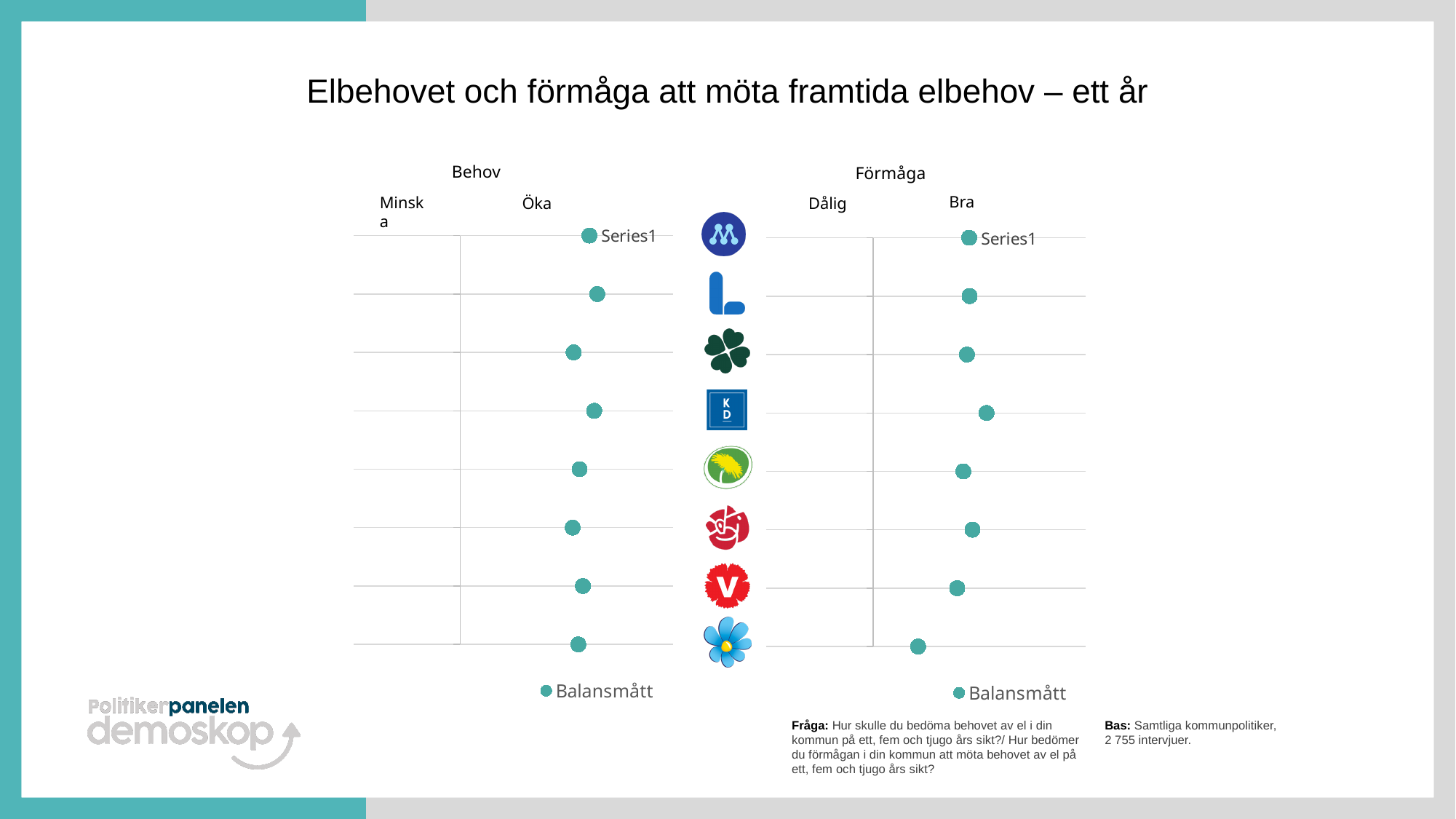
In the "Behov" chart, are the points on the "Minska" side or the "Öka" side of the vertical centre line? Öka What is the name of the series shown in the legend below the "Förmåga" chart? Balansmått How many data points are plotted in the "Förmåga" chart? 8 What is the title of the chart on the left side of the slide? Behov How many data points are plotted in the "Behov" chart? 8 In the "Förmåga" chart, is the bottom point to the left or to the right of the fourth point from the top? left In the "Förmåga" chart, are the points on the "Dålig" side or the "Bra" side of the vertical centre line? Bra In the "Förmåga" chart, which point lies furthest to the right (towards "Bra")? the fourth point from the top What kind of chart is the "Behov" chart on the left? dot chart How many series does the legend of the "Behov" chart list? 1 In the "Förmåga" chart, which point lies furthest to the left (towards "Dålig")? the bottom point